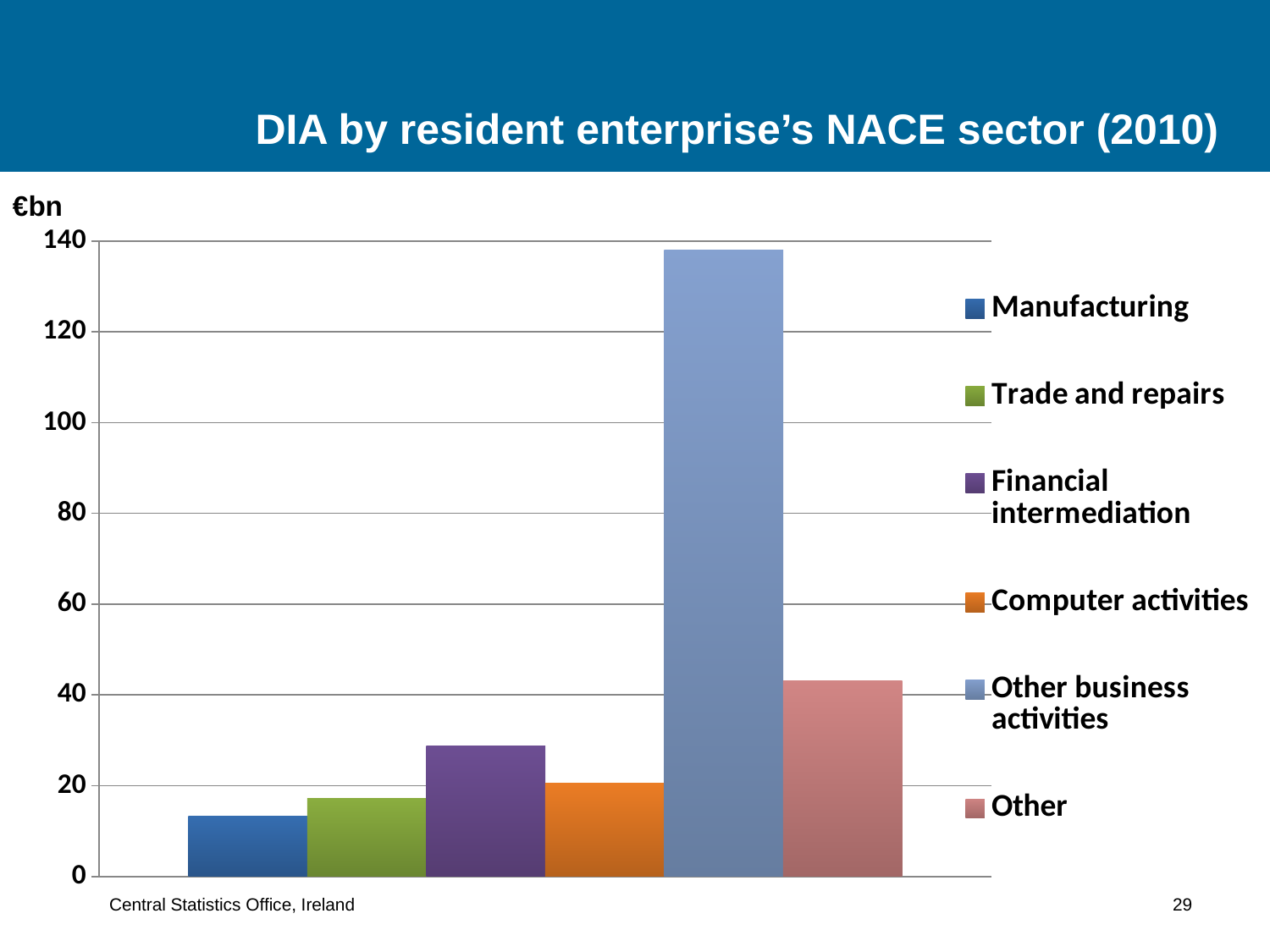
What unit is shown on the vertical axis of the chart? €bn Is the value for Manufacturing greater or less than 20? less Which is larger, the value for Other or the value for Financial intermediation? Other Is the value for Financial intermediation greater or less than 20? greater How many series does the legend list? 6 Which sector has the highest value? Other business activities Is the value for Other greater or less than 60? less What kind of chart is shown on the slide? bar chart Which sector has the lowest value? Manufacturing Which is larger, the value for Financial intermediation or the value for Computer activities? Financial intermediation